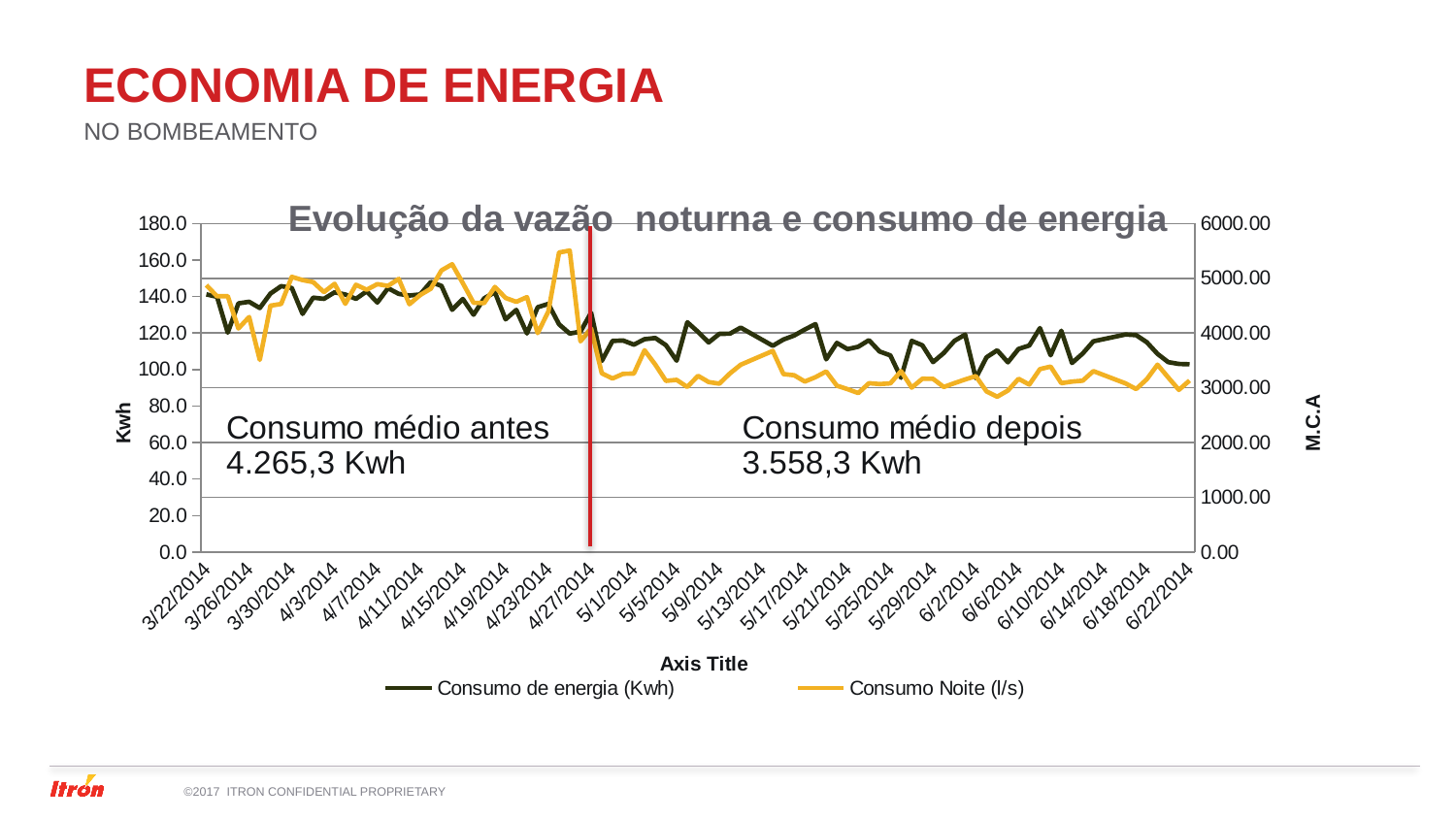
What are the two series named in the chart legend? Consumo de energia (Kwh) and Consumo Noite (l/s) What is the difference between the average consumption before (4.265,3 Kwh) and after (3.558,3 Kwh)? 707,0 Kwh What is the title of the chart? Evolução da vazão noturna e consumo de energia What is the average consumption after (Consumo médio depois) shown on the chart? 3.558,3 Kwh Reading against the left axis, is the Consumo Noite (l/s) line at 6/22/2014 greater or less than 120? less What is the average consumption before (Consumo médio antes) shown on the chart? 4.265,3 Kwh Which is larger, the average consumption before or the average consumption after? Consumo médio antes (before) What kind of chart is shown on the slide? Line chart Do the values of the Consumo de energia (Kwh) line generally rise or fall from left to right across the dates? Fall How many series does the chart legend list? 2